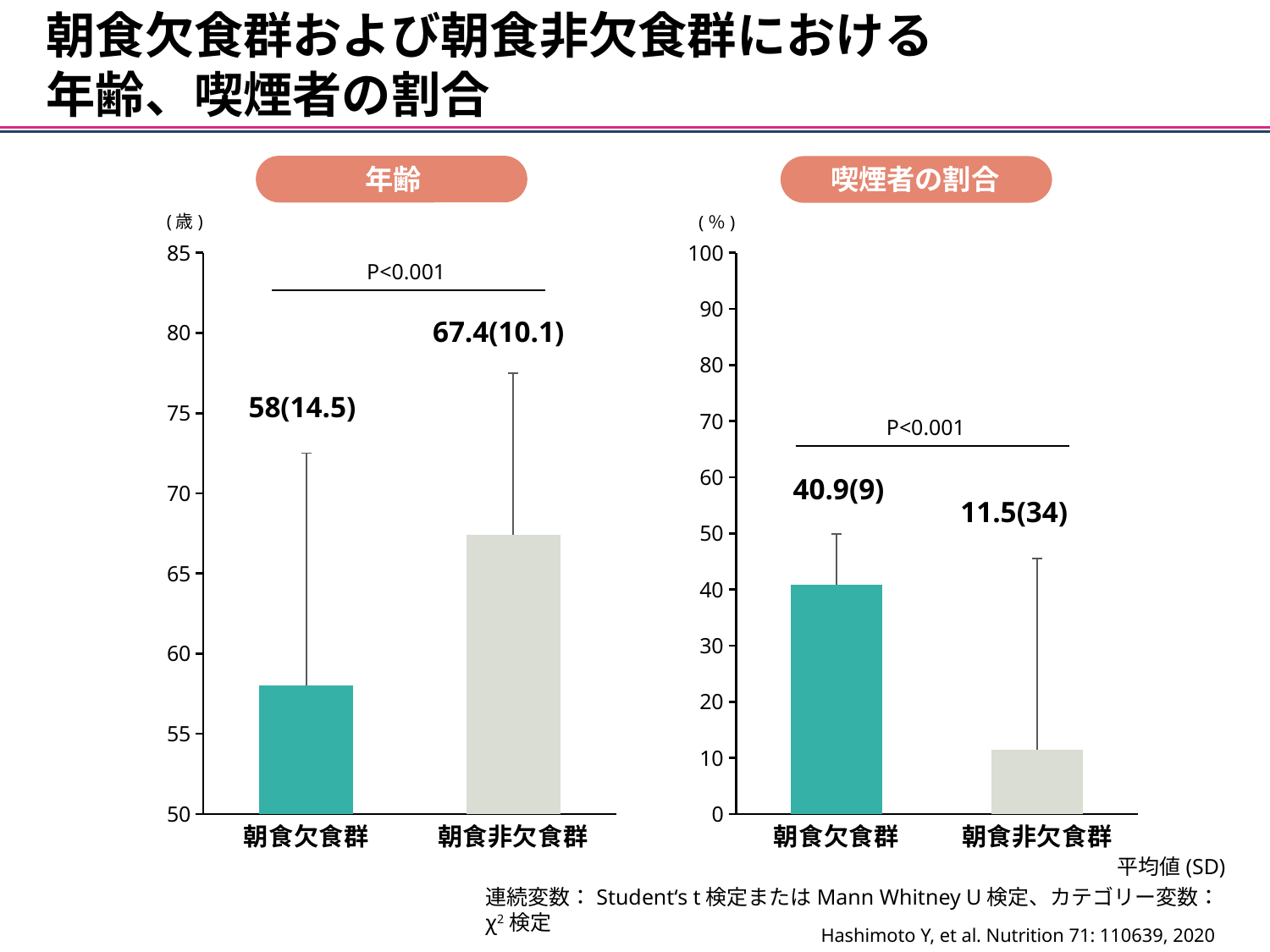
In the 喫煙者の割合 chart, what is the difference between the smoker proportions of 朝食欠食群 and 朝食非欠食群? 29.4 In the 年齢 chart, what is the value printed for 朝食欠食群? 58(14.5) What kind of chart is the 喫煙者の割合 chart? bar chart In the 年齢 chart, what is the value printed for 朝食非欠食群? 67.4(10.1) In the 喫煙者の割合 chart, what is the value printed for 朝食非欠食群? 11.5(34) In the 喫煙者の割合 chart, is the value for 朝食欠食群 greater or less than 30? greater In the 年齢 chart, what is the difference between the mean ages of 朝食非欠食群 and 朝食欠食群? 9.4 How many categories are shown on the x axis of the 年齢 chart? 2 In the 年齢 chart, which group has the higher mean age? 朝食非欠食群 In the 喫煙者の割合 chart, which group has the lower proportion of smokers? 朝食非欠食群 What P value is printed above the bars in the 年齢 chart? P<0.001 In the 喫煙者の割合 chart, what is the value printed for 朝食欠食群? 40.9(9)